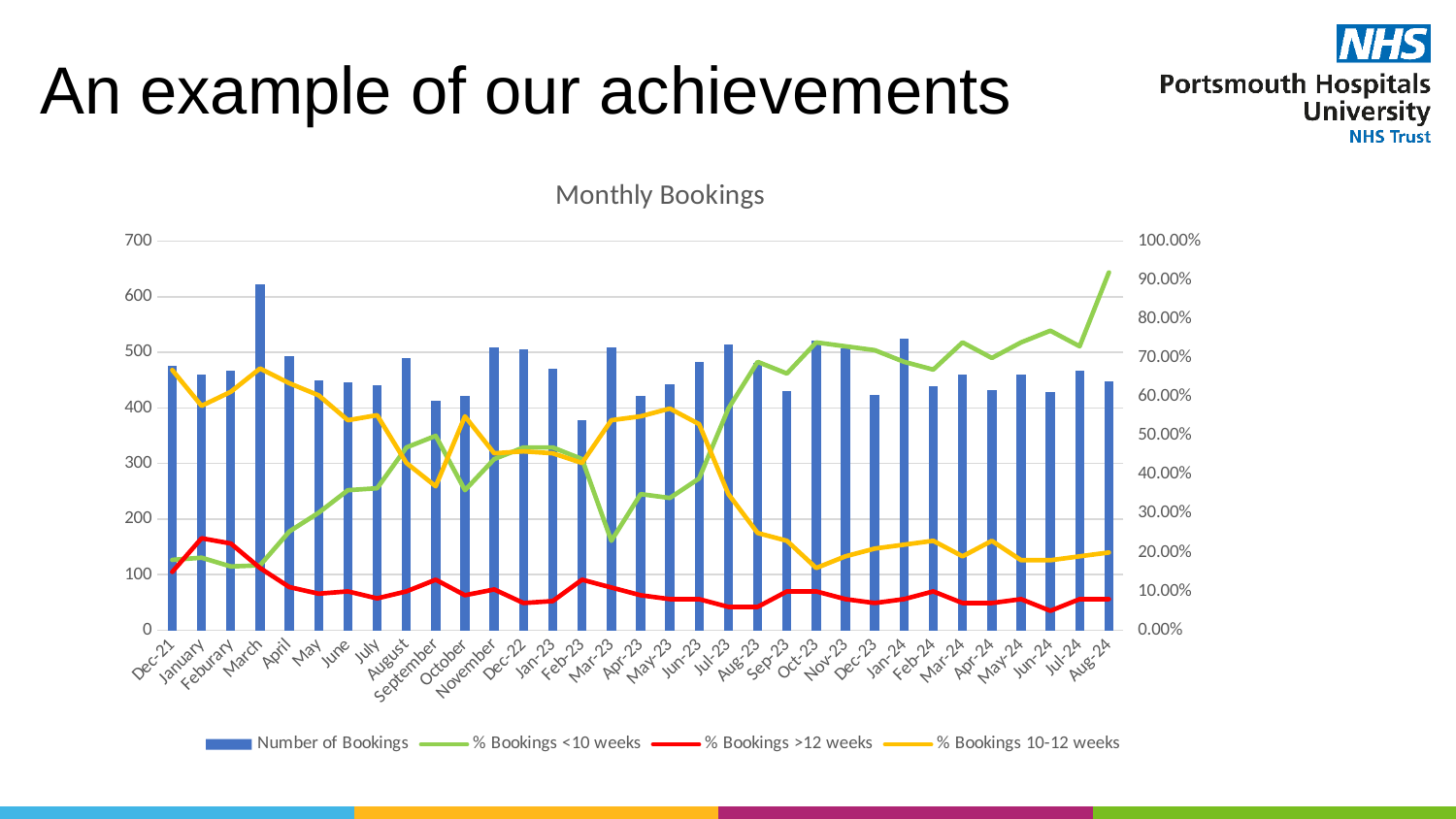
Which month has the highest Number of Bookings bar? March What is the title of the chart? Monthly Bookings Which month has the lowest Number of Bookings bar? Feb-23 Is the % Bookings <10 weeks value for Aug-24 greater or less than 80.00%? greater Overall, does the % Bookings >12 weeks line rise or fall from Dec-21 to Aug-24? fall What kind of chart is shown on the slide? A combination bar and line chart Which has the larger Number of Bookings, March or Feb-23? March Is the % Bookings >12 weeks value for Dec-21 greater or less than 20.00%? less Is the Number of Bookings for March greater or less than 600? greater How many series does the chart legend list? 4 How many months (bars) are plotted on the x axis? 33